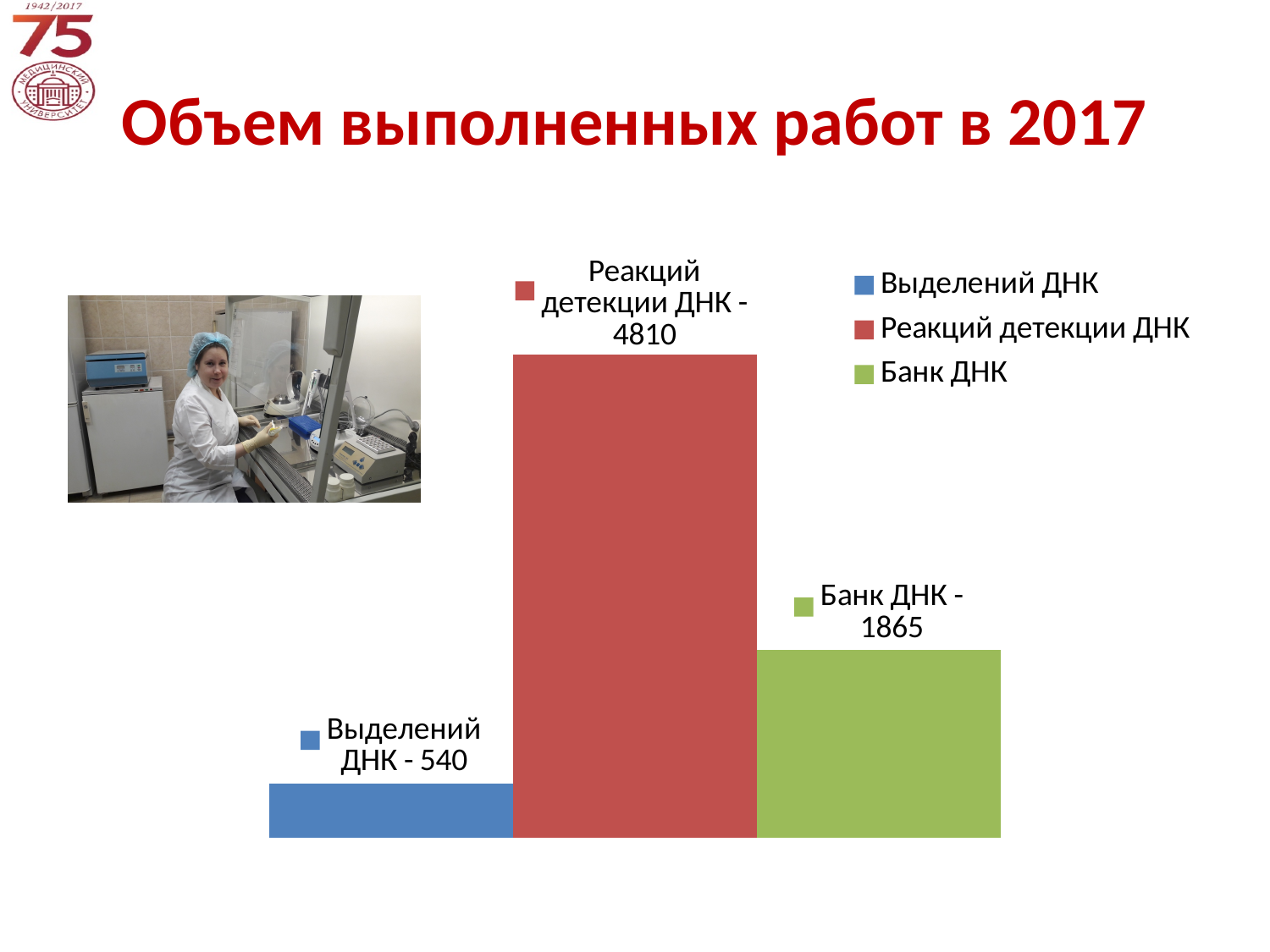
What is the value for Банк ДНК? 1865 What is the difference between the values for Реакций детекции ДНК and Банк ДНК? 2945 What is the value for Реакций детекции ДНК? 4810 What is the value for Выделений ДНК? 540 Which is larger, the value for Банк ДНК or the value for Выделений ДНК? Банк ДНК What is the difference between the values for Банк ДНК and Выделений ДНК? 1325 What colour is the bar for Реакций детекции ДНК? red How many entries does the legend list? 3 Which category has the lowest value? Выделений ДНК Which category has the highest value? Реакций детекции ДНК How many bars are shown in the chart? 3 What kind of chart is shown on the slide? bar chart